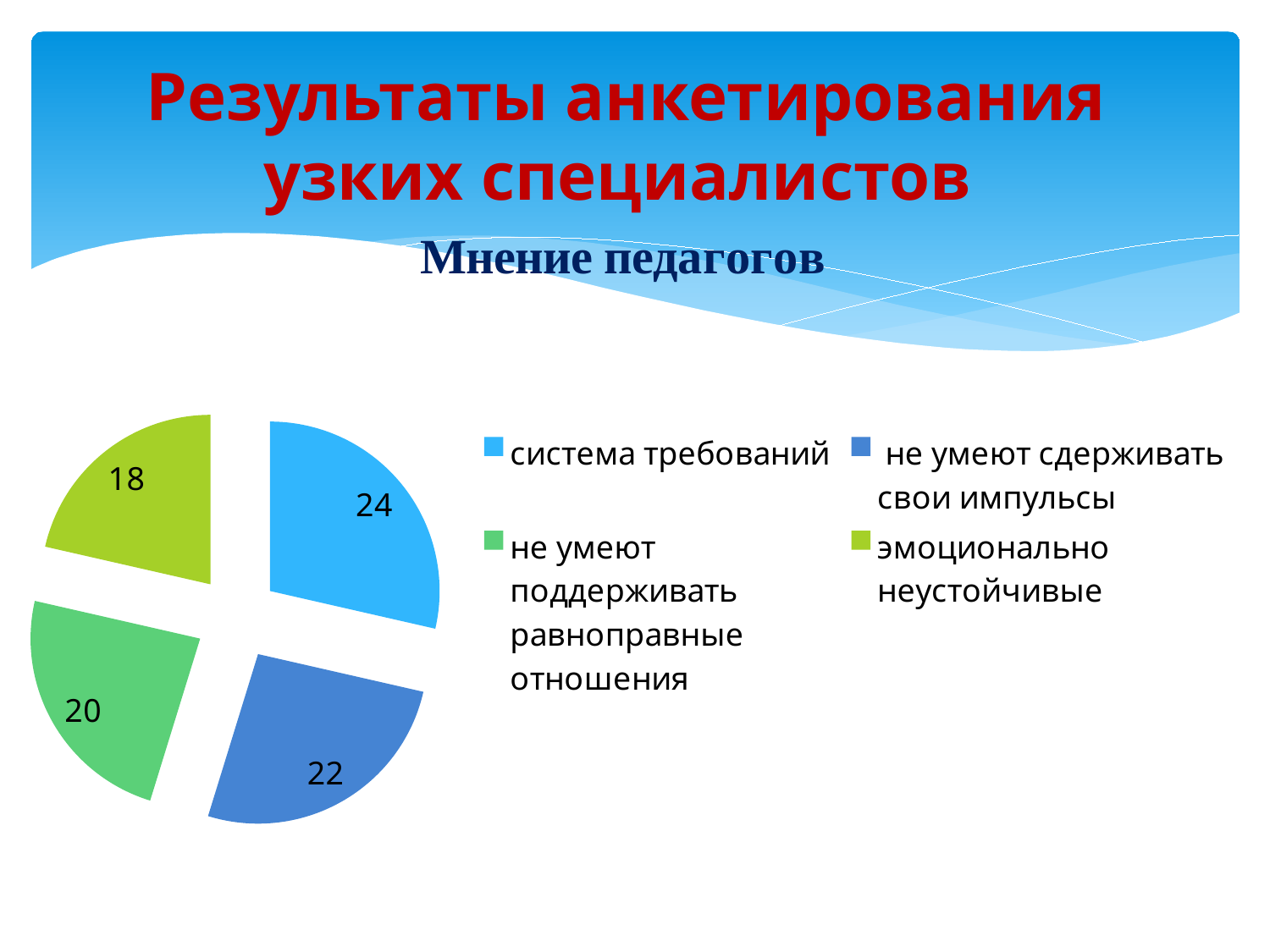
What is the value for "система требований"? 24 Which is larger: the value for "не умеют сдерживать свои импульсы" or the value for "не умеют поддерживать равноправные отношения"? не умеют сдерживать свои импульсы What is the value for "не умеют сдерживать свои импульсы"? 22 What kind of chart is shown on the slide? Pie chart What is the total of all the values in the pie chart? 84 What colour is the slice for "эмоционально неустойчивые"? Yellow-green Which category has the smallest slice of the pie? эмоционально неустойчивые Which category has the largest slice of the pie? система требований What is the value for "не умеют поддерживать равноправные отношения"? 20 What is the difference between the values for "система требований" and "эмоционально неустойчивые"? 6 What is the value for "эмоционально неустойчивые"? 18 How many slices does the pie chart have? 4